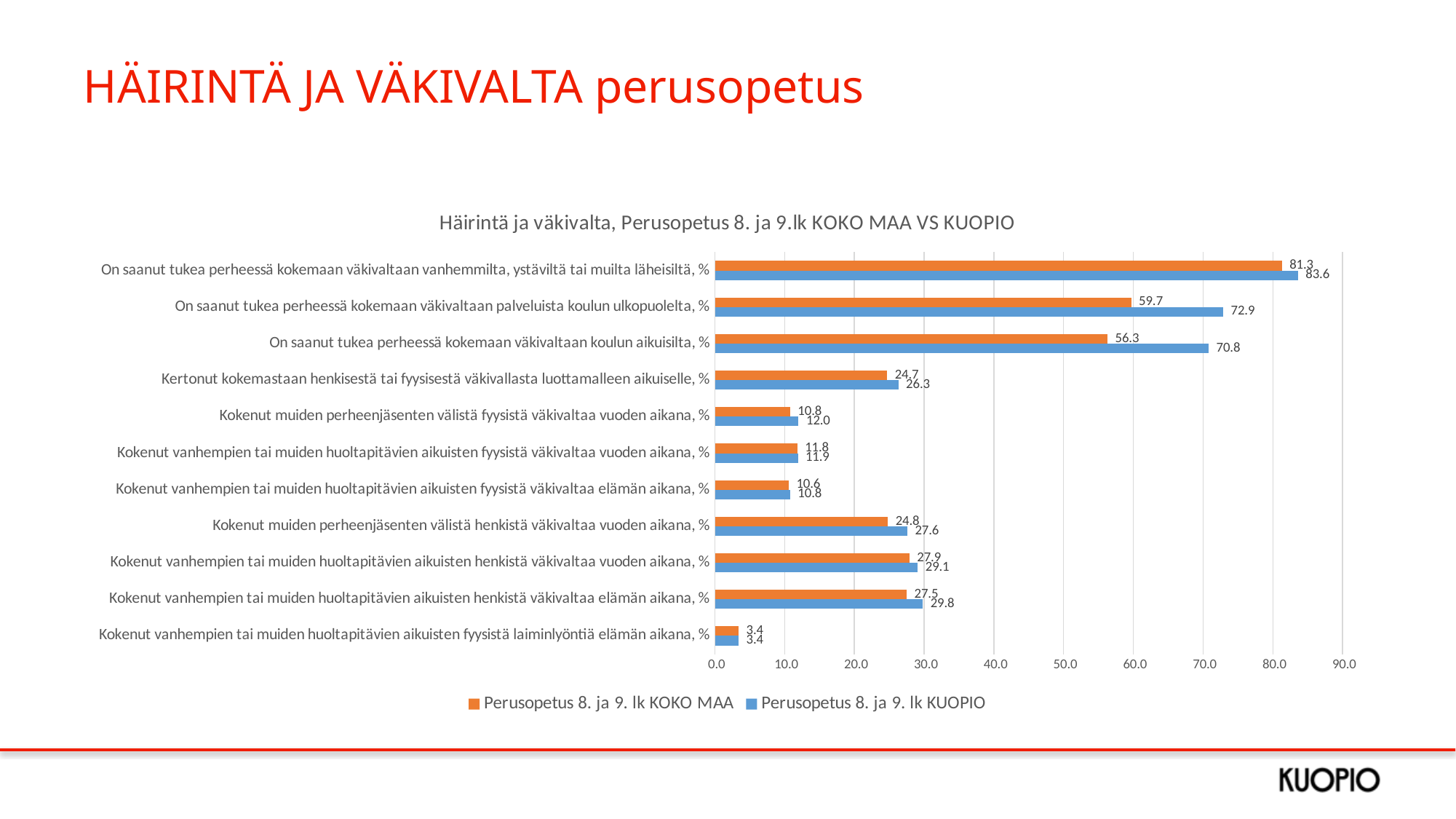
What is the value for 'Perusopetus 8. ja 9. lk KOKO MAA' in the category 'On saanut tukea perheessä kokemaan väkivaltaan koulun aikuisilta, %'? 56.3 What is the value for 'Perusopetus 8. ja 9. lk KUOPIO' in the category 'On saanut tukea perheessä kokemaan väkivaltaan palveluista koulun ulkopuolelta, %'? 72.9 What is the difference between the KUOPIO and KOKO MAA values for 'On saanut tukea perheessä kokemaan väkivaltaan koulun aikuisilta, %'? 14.5 How many series does the legend list? 2 Which category has the highest value for 'Perusopetus 8. ja 9. lk KUOPIO'? On saanut tukea perheessä kokemaan väkivaltaan vanhemmilta, ystäviltä tai muilta läheisiltä, % What is the difference between the KUOPIO and KOKO MAA values for 'On saanut tukea perheessä kokemaan väkivaltaan palveluista koulun ulkopuolelta, %'? 13.2 What type of chart is shown on the slide? bar chart How many categories are plotted in the chart? 11 Which category has the lowest value for 'Perusopetus 8. ja 9. lk KOKO MAA'? Kokenut vanhempien tai muiden huoltapitävien aikuisten fyysistä laiminlyöntiä elämän aikana, % For 'Kokenut muiden perheenjäsenten välistä henkistä väkivaltaa vuoden aikana, %', which series has the larger value, KOKO MAA or KUOPIO? KUOPIO What is the value for 'Perusopetus 8. ja 9. lk KUOPIO' in the category 'Kokenut vanhempien tai muiden huoltapitävien aikuisten henkistä väkivaltaa elämän aikana, %'? 29.8 What is the title of the chart? Häirintä ja väkivalta, Perusopetus 8. ja 9.lk KOKO MAA VS KUOPIO